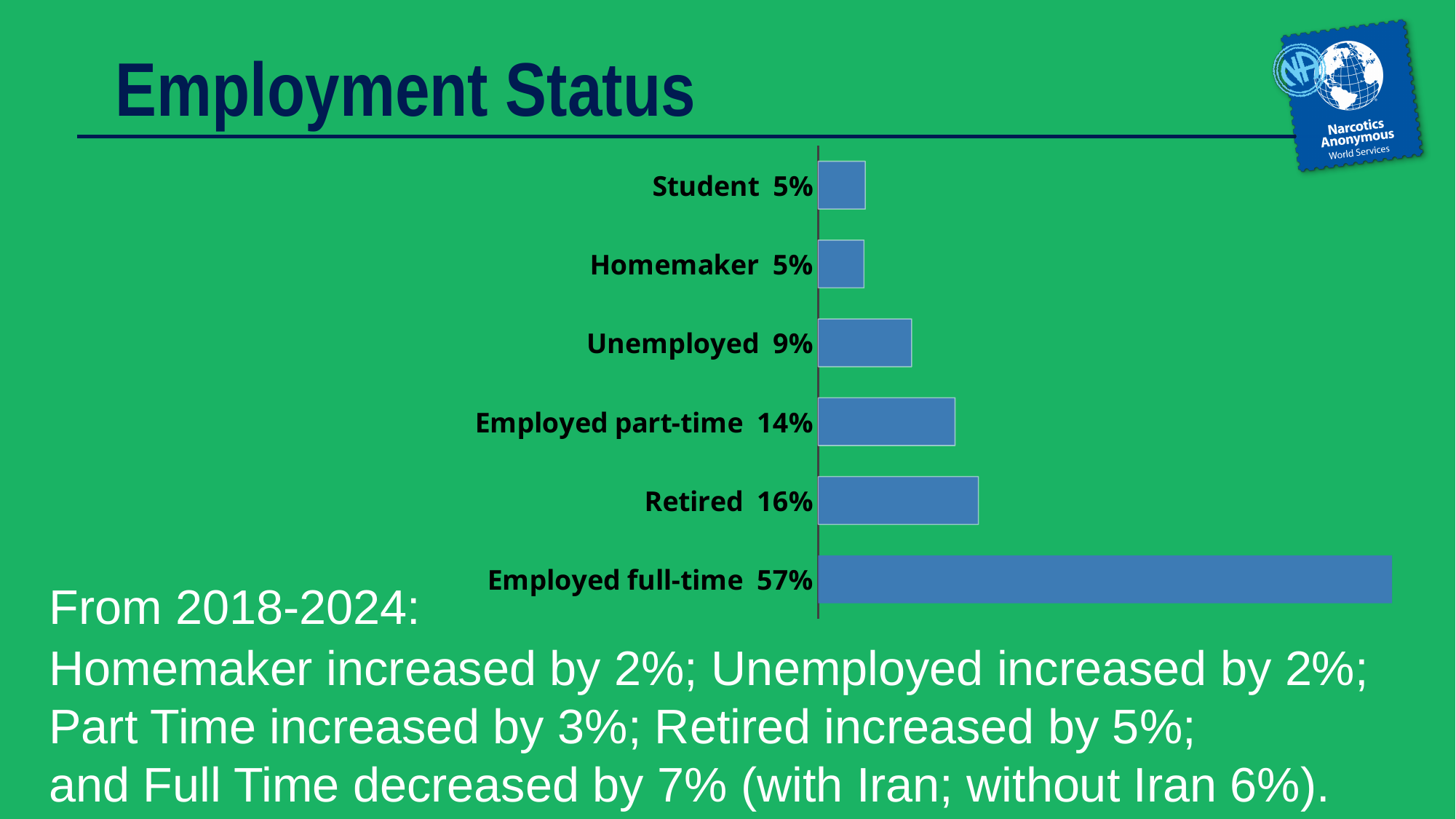
What is the difference between Employed full-time and Retired? 41% Which category has the highest value? Employed full-time Which two categories share the same value of 5%? Student and Homemaker Which is larger, Unemployed or Employed part-time? Employed part-time What percentage is shown for Unemployed? 9% What percentage is shown for Retired? 16% How many categories are shown in the chart? 6 What percentage is shown for Employed full-time? 57% What is the title of the slide? Employment Status What is the difference between Retired and Employed part-time? 2% What kind of chart is shown on the slide? Bar chart What percentage is shown for Employed part-time? 14%